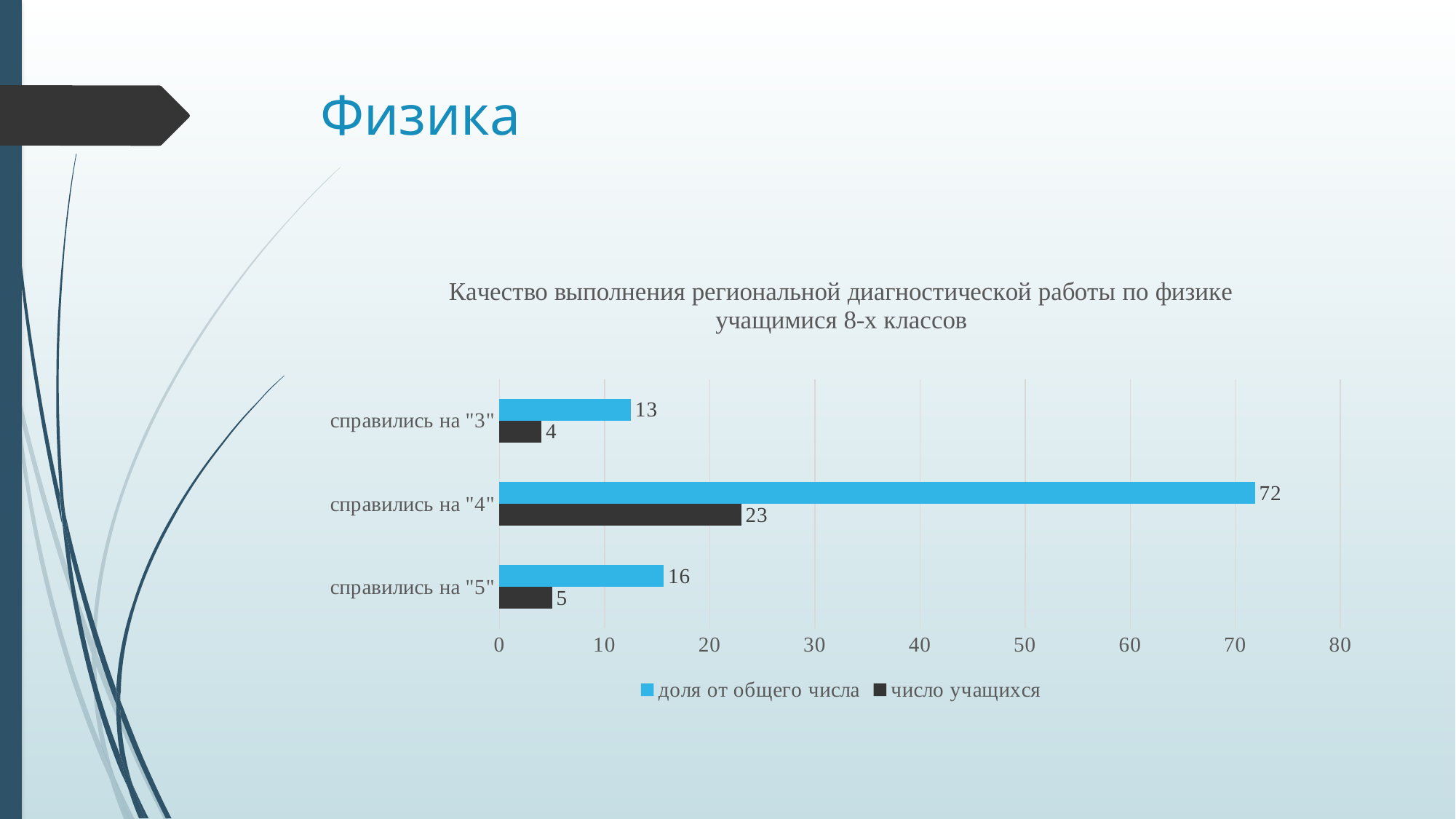
Which category has the lowest value for "доля от общего числа"? справились на "3" How many categories are shown on the chart? 3 What is the value of "доля от общего числа" for справились на "5"? 16 How many series does the legend list? 2 What is the total of "число учащихся" across all three categories? 32 Which category has the highest value for "число учащихся"? справились на "4" What is the value of "число учащихся" for справились на "3"? 4 What is the value of "число учащихся" for справились на "5"? 5 What is the value of "доля от общего числа" for справились на "4"? 72 What is the difference between the "доля от общего числа" values for справились на "4" and справились на "5"? 56 What type of chart is shown on the slide? Bar chart Which is larger: "доля от общего числа" for справились на "5" or for справились на "3"? справились на "5"